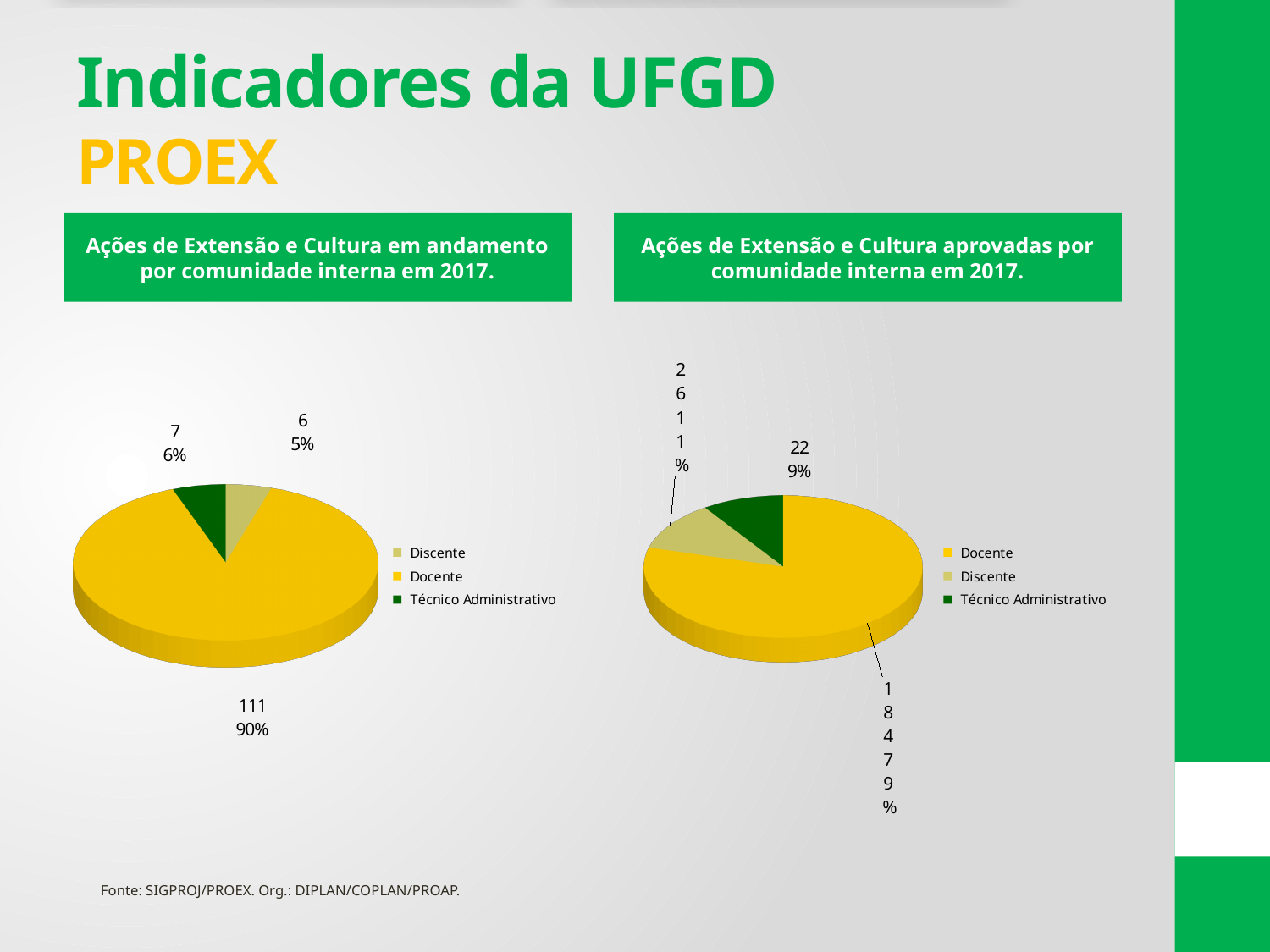
In the right chart (Ações aprovadas), which colour represents Técnico Administrativo in the legend? Dark green In the right chart (Ações aprovadas), which category has the largest value? Docente In the left chart (Ações em andamento), what is the difference between the Docente and Técnico Administrativo values? 104 In the left chart (Ações em andamento), what share of the pie does Discente represent? 5% What kind of chart is used for 'Ações de Extensão e Cultura em andamento por comunidade interna em 2017'? Pie chart In the left chart (Ações em andamento), what is the value for Docente? 111 In the right chart (Ações aprovadas), what is the value for Técnico Administrativo? 22 In the right chart (Ações aprovadas), what share of the pie does Técnico Administrativo represent? 9% How many categories does the legend of the left chart (Ações em andamento) list? 3 In the left chart (Ações em andamento), which category has the smallest value? Discente In the left chart (Ações em andamento), what share of the pie does Docente represent? 90% In the left chart (Ações em andamento), what is the value for Técnico Administrativo? 7